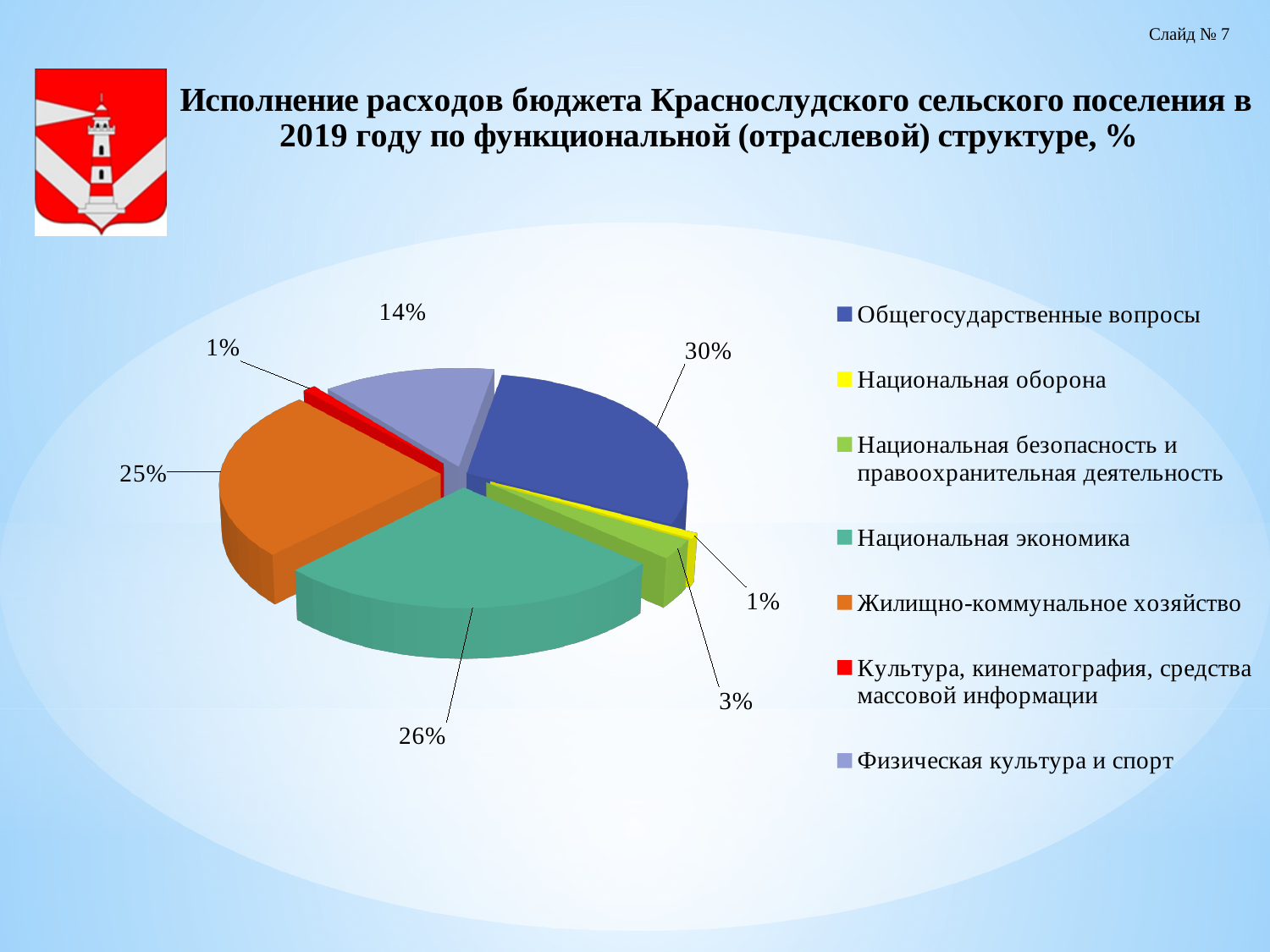
Which category has the largest share of the pie? Общегосударственные вопросы How many categories does the legend list? 7 Which is larger: the share of Национальная экономика or the share of Жилищно-коммунальное хозяйство? Национальная экономика What is the difference between the shares of Общегосударственные вопросы and Физическая культура и спорт? 16 percentage points What share of expenditures goes to Физическая культура и спорт? 14% What colour is the slice for Культура, кинематография, средства массовой информации? red What type of chart is shown on the slide? pie chart What share of expenditures goes to Жилищно-коммунальное хозяйство? 25% What share of expenditures goes to Общегосударственные вопросы? 30% What share of expenditures goes to Национальная экономика? 26% What share of expenditures goes to Национальная оборона? 1% What share of expenditures goes to Национальная безопасность и правоохранительная деятельность? 3%